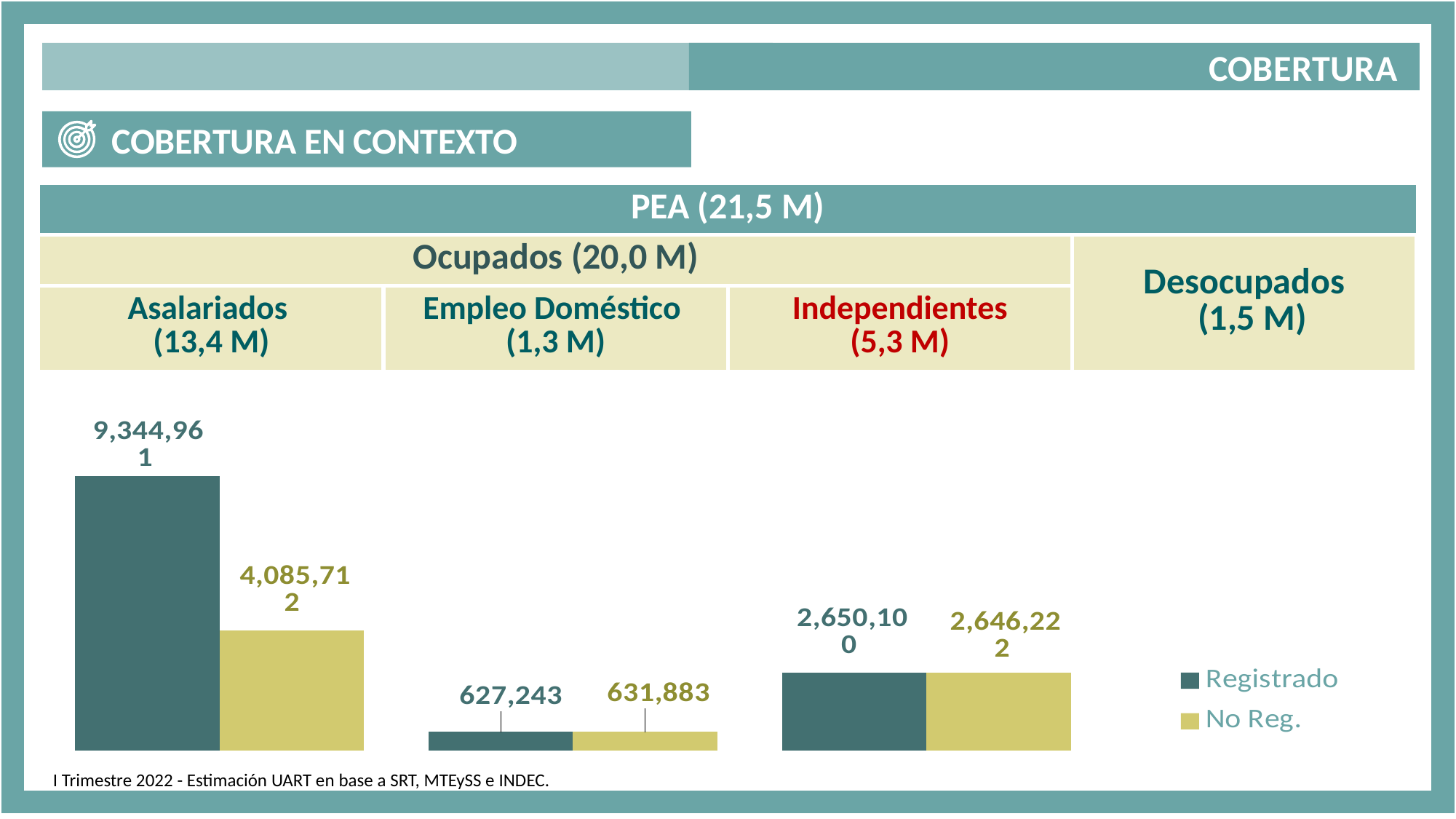
What is the No Reg. value for Asalariados? 4,085,712 Which category has the lowest No Reg. value? Empleo Doméstico What is the No Reg. value for Independientes? 2,646,222 What are the two legend entries of the chart? Registrado and No Reg. Which category has the highest Registrado value? Asalariados What is the difference between the Registrado and No Reg. values for Asalariados? 5,259,249 How many series does the legend list? 2 What is the Registrado value for Asalariados? 9,344,961 What is the Registrado value for Empleo Doméstico? 627,243 What is the No Reg. value for Empleo Doméstico? 631,883 What is the Registrado value for Independientes? 2,650,100 What kind of chart is shown on the slide? Bar chart